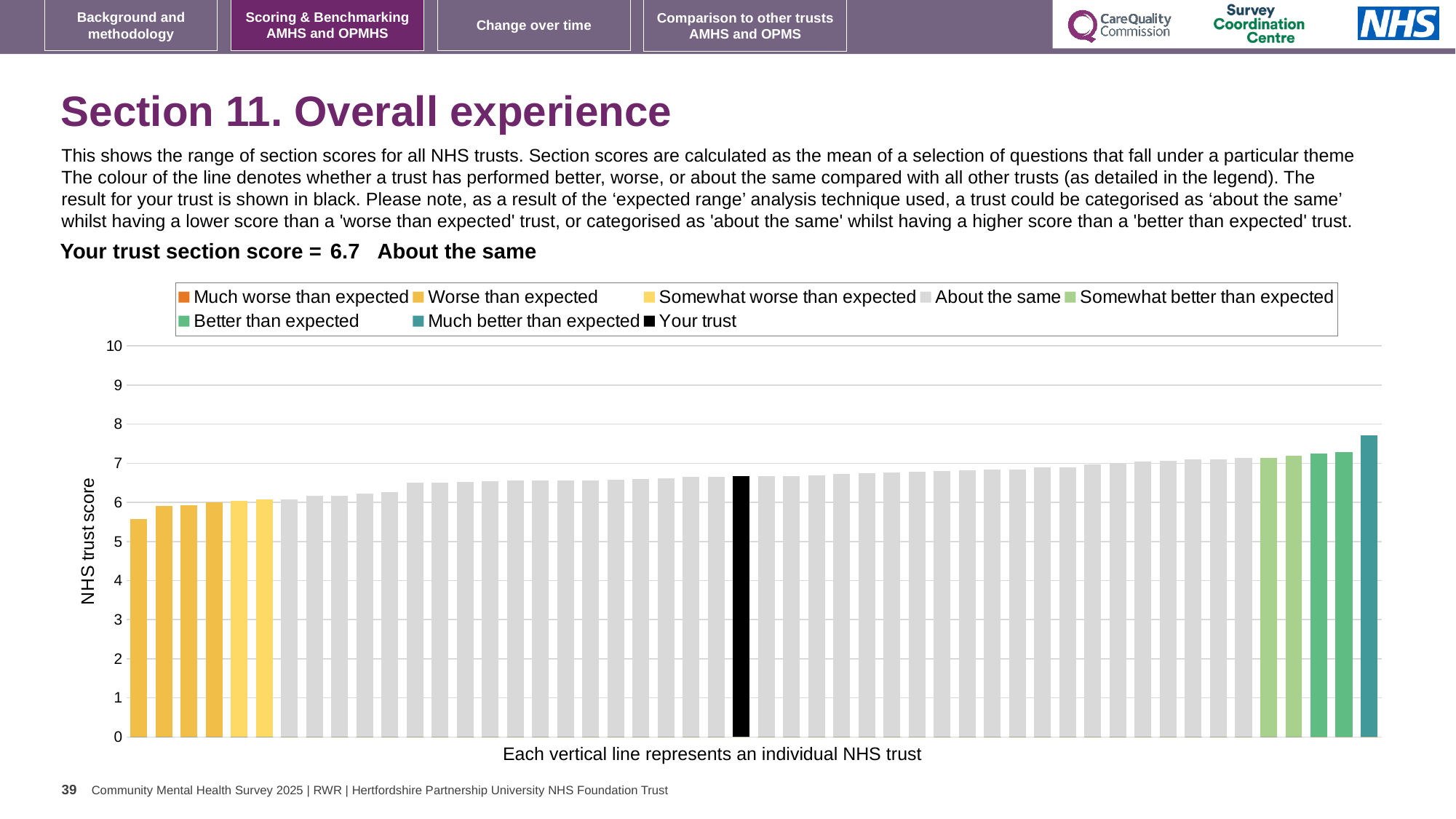
What kind of chart is shown on the slide? bar chart What is the label on the y axis of the chart? NHS trust score Which category does your trust fall into for this section? About the same What colour is used for the bar representing your trust? black Is the value of the tallest bar (rightmost) greater or less than 7? greater Is the value for your trust (the black bar) greater or less than 6? greater Is the value for your trust (the black bar) greater or less than 7? less Do the bar values rise or fall from left to right along the x axis? rise What is the section score for your trust shown on the slide? 6.7 How many entries does the legend list? 8